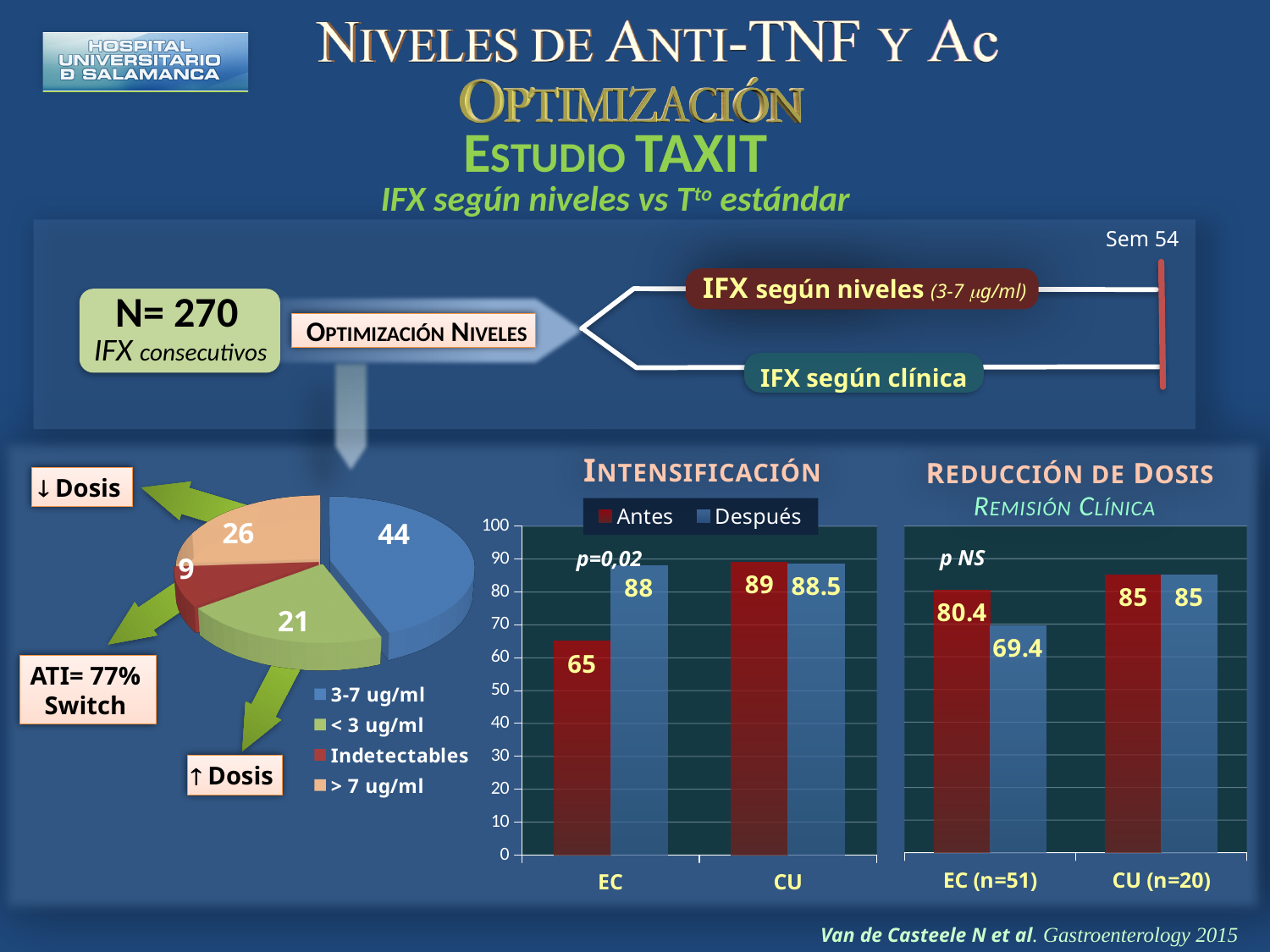
In the Intensificación chart, what is the value for Antes in the EC category? 65 In the Reducción de Dosis chart, what is the difference between Antes and Después for EC (n=51)? 11 In the Reducción de Dosis chart, what is the value for Después in the EC (n=51) category? 69.4 In the Intensificación chart, what is the value for Después in the CU category? 88.5 In the pie chart on the left, which category has the smallest slice? Indetectables How many series does the legend of the Intensificación chart list? 2 In the Reducción de Dosis chart, what is the value for Antes in the CU (n=20) category? 85 What kind of chart is the Reducción de Dosis chart? Bar chart In the Intensificación chart, which is larger for CU: Antes or Después? Antes How many slices does the pie chart on the left have? 4 In the Intensificación chart, what is the difference between Después and Antes for EC? 23 In the pie chart on the left, what is the value for the 3-7 ug/ml slice? 44